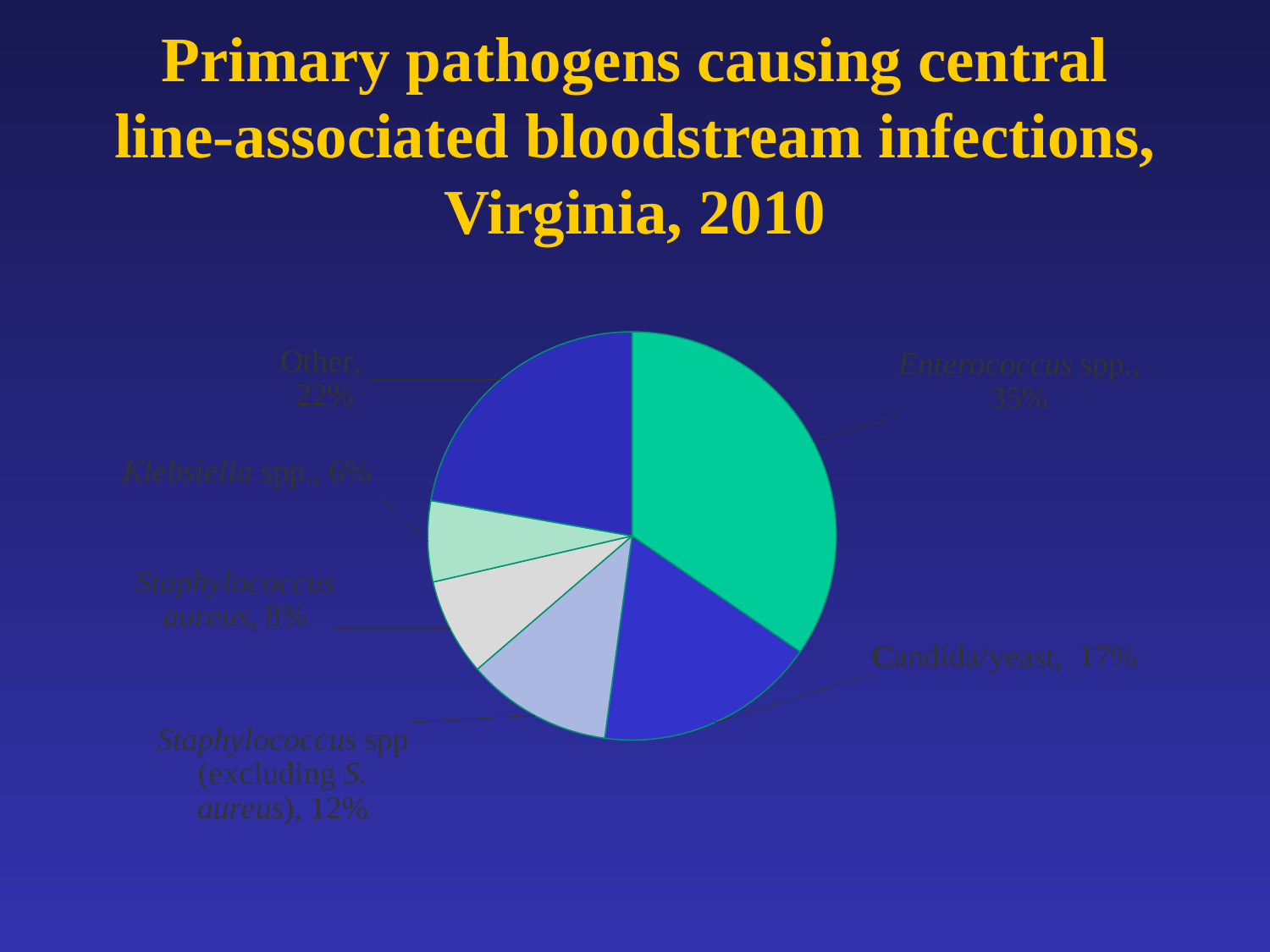
What percentage is shown for Klebsiella spp.? 6% What percentage is shown for Staphylococcus spp (excluding S. aureus)? 12% What percentage is shown for Candida/yeast? 17% Which is larger, the share for Staphylococcus aureus or the share for Klebsiella spp.? Staphylococcus aureus What is the difference in percentage points between Enterococcus spp. and Candida/yeast? 18 What percentage is shown for Staphylococcus aureus? 8% What kind of chart is shown on the slide? Pie chart Which pathogen category has the smallest slice of the pie? Klebsiella spp. How many slices does the pie chart have? 6 What share of central line-associated bloodstream infections is attributed to Enterococcus spp.? 35% What percentage of the pie is labelled Other? 22% Which pathogen category has the largest slice of the pie? Enterococcus spp.